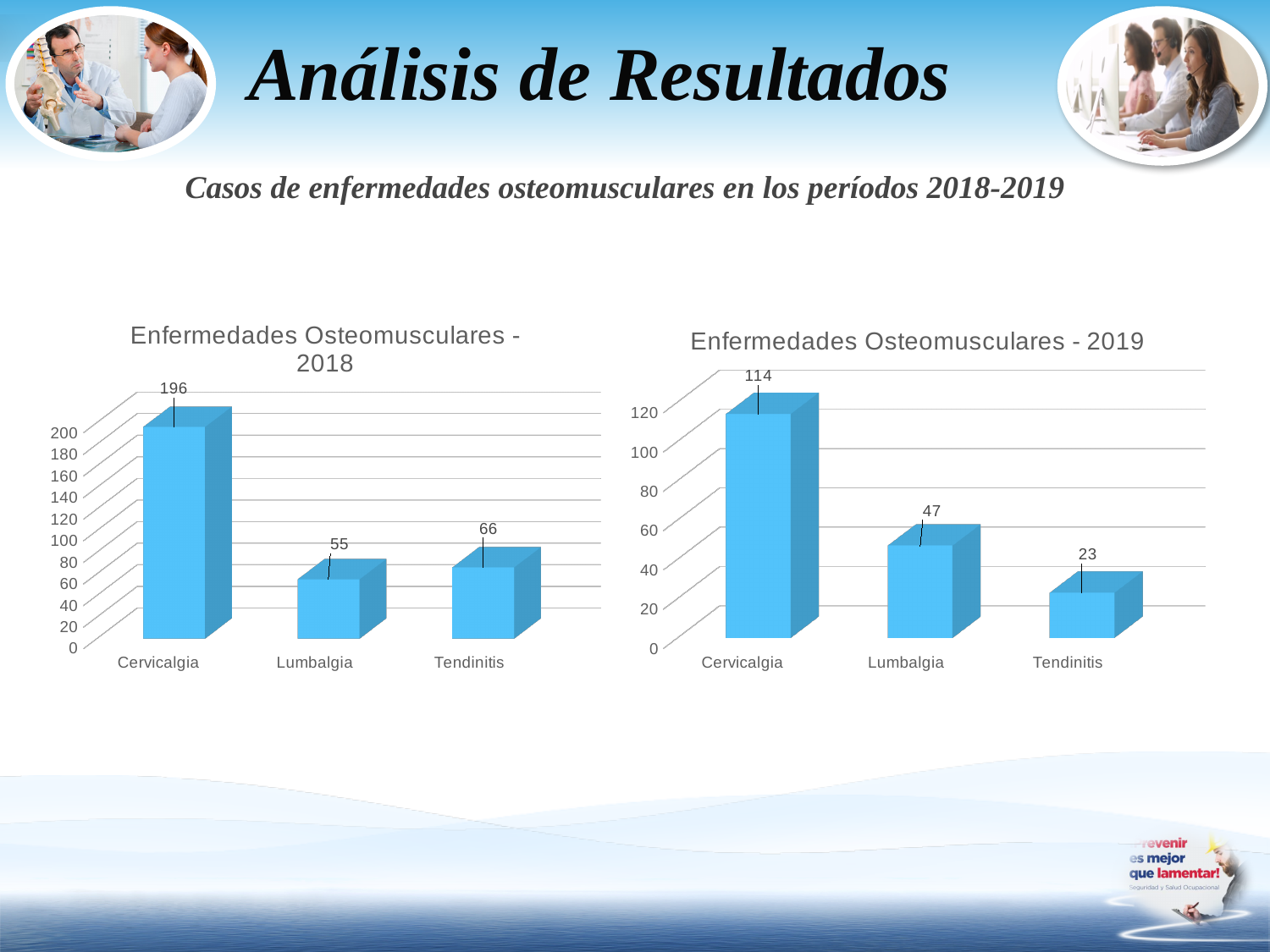
In the 'Enfermedades Osteomusculares - 2018' chart, which is larger, Lumbalgia or Tendinitis? Tendinitis What is the title of the chart on the right side of the slide? Enfermedades Osteomusculares - 2019 In the 'Enfermedades Osteomusculares - 2019' chart, what is the value for Tendinitis? 23 In the 'Enfermedades Osteomusculares - 2019' chart, which category has the highest value? Cervicalgia What kind of chart is 'Enfermedades Osteomusculares - 2018'? Bar chart In the 'Enfermedades Osteomusculares - 2019' chart, do the values rise or fall from Cervicalgia to Tendinitis? Fall In the 'Enfermedades Osteomusculares - 2018' chart, what is the difference between Cervicalgia and Tendinitis? 130 In the 'Enfermedades Osteomusculares - 2019' chart, is the value for Cervicalgia greater or less than 100? greater In the 'Enfermedades Osteomusculares - 2019' chart, what is the difference between Lumbalgia and Tendinitis? 24 In the 'Enfermedades Osteomusculares - 2018' chart, which category has the lowest value? Lumbalgia In the 'Enfermedades Osteomusculares - 2018' chart, what is the value for Cervicalgia? 196 How many categories are shown in the 'Enfermedades Osteomusculares - 2019' chart? 3